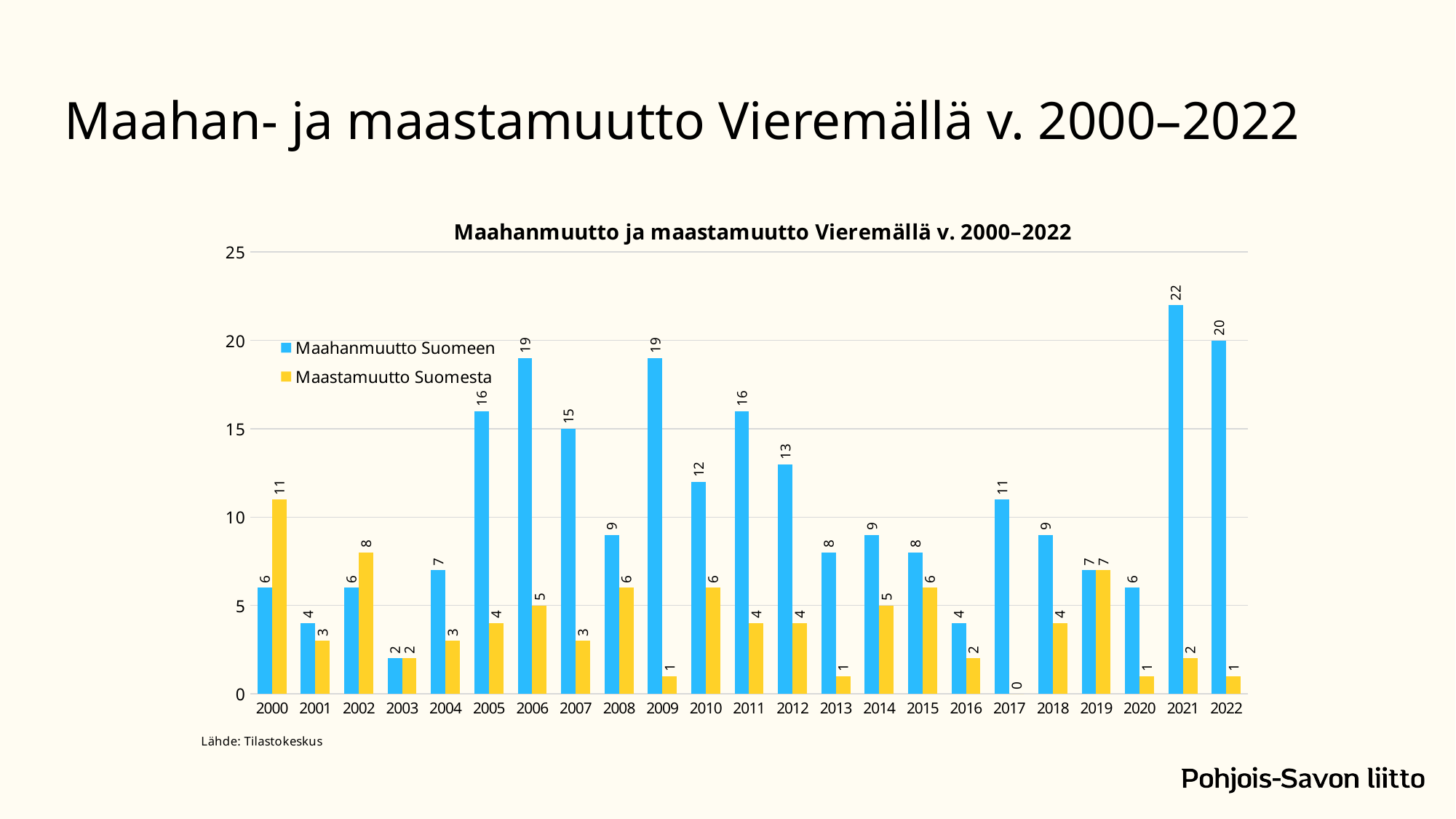
What kind of chart is shown on the slide? Bar chart What is the difference between Maahanmuutto Suomeen and Maastamuutto Suomesta in 2022? 19 How many years are shown on the x axis? 23 How many series does the legend list? 2 What is the value of Maahanmuutto Suomeen in 2009? 19 Which is larger in 2002: Maahanmuutto Suomeen or Maastamuutto Suomesta? Maastamuutto Suomesta In which year is Maahanmuutto Suomeen highest? 2021 What is the title of the chart? Maahanmuutto ja maastamuutto Vieremällä v. 2000–2022 In which year is Maastamuutto Suomesta highest? 2000 What is the value of Maahanmuutto Suomeen in 2021? 22 What is the value of Maastamuutto Suomesta in 2000? 11 In which year is Maastamuutto Suomesta lowest? 2017